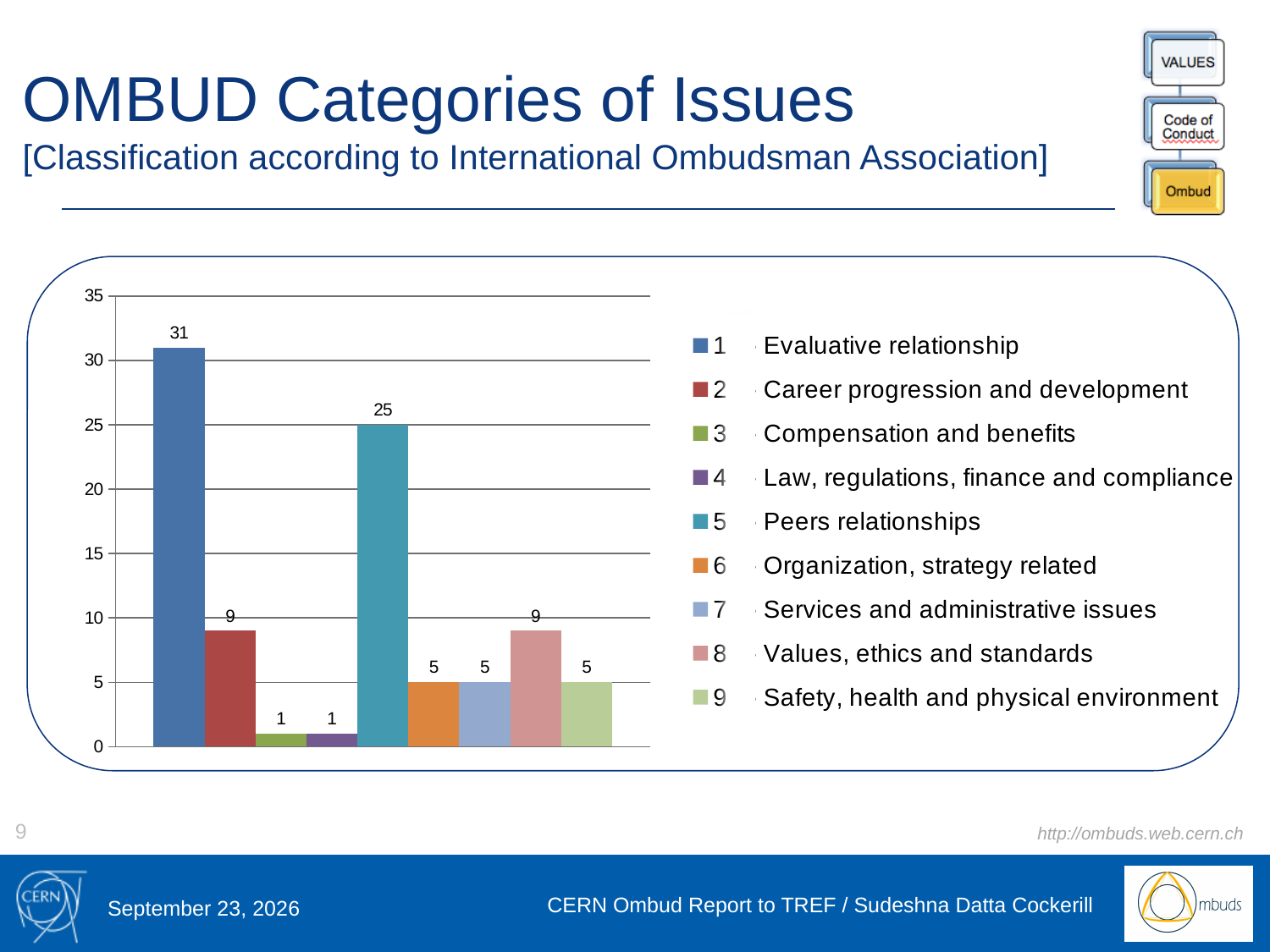
What is the value for Compensation and benefits? 1 Which category has the highest value? Evaluative relationship What is the difference between the values for Career progression and development and Organization, strategy related? 4 How many bars are plotted in the chart? 9 What is the value for Career progression and development? 9 Is the value for Peers relationships greater or less than 20? greater What kind of chart is shown on the slide? Bar chart How many entries does the legend list? 9 What is the value for Evaluative relationship? 31 Which is larger, the value for Values, ethics and standards or the value for Safety, health and physical environment? Values, ethics and standards What is the value for Peers relationships? 25 What is the difference between the values for Evaluative relationship and Peers relationships? 6